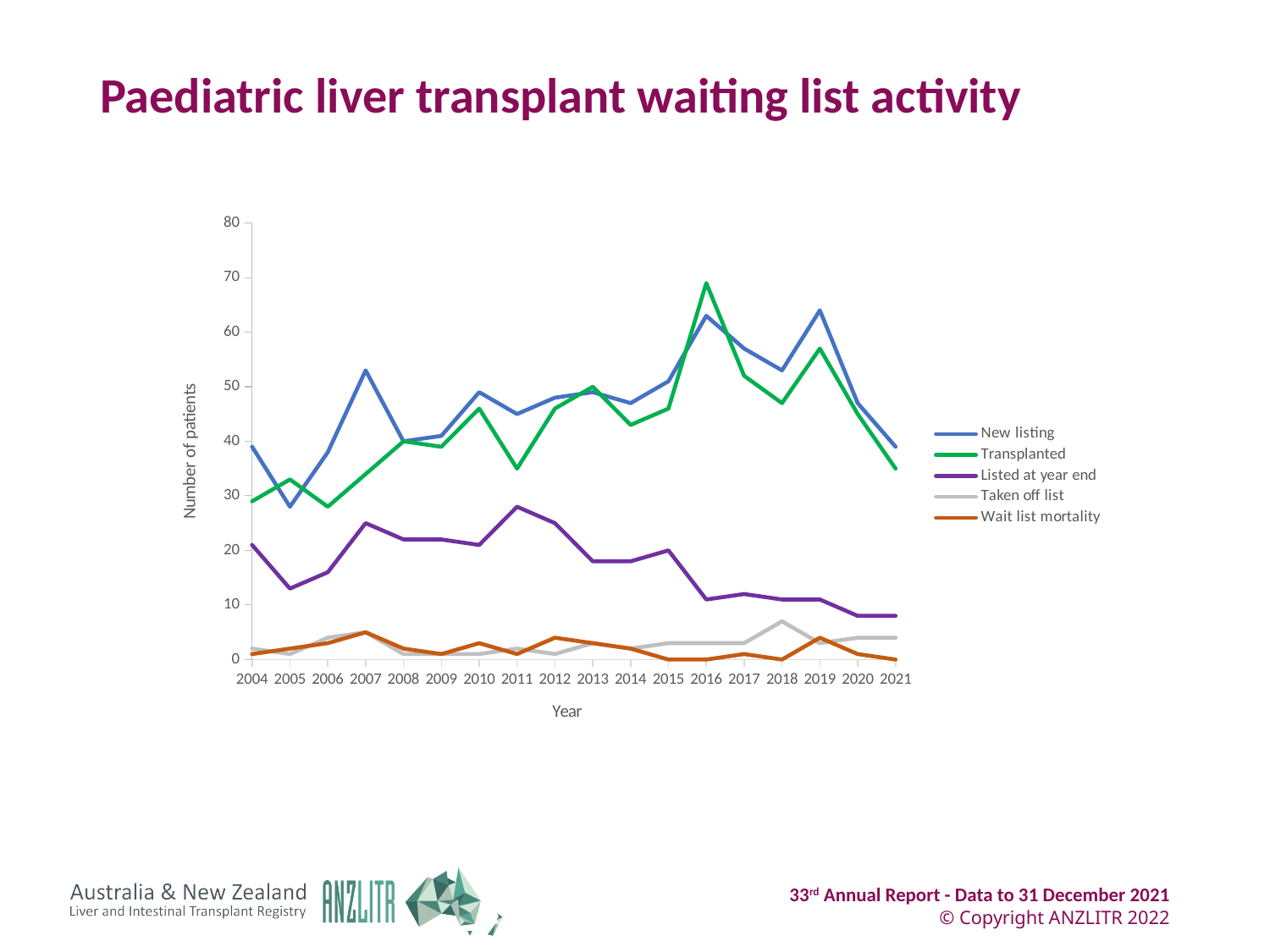
Is the Listed at year end value for 2016 greater or less than 20? less How many series does the legend list? 5 In which year does the Transplanted series reach its highest value? 2016 Does the Listed at year end series generally rise or fall from 2011 to 2021? Fall How many years are plotted along the x axis? 18 In 2011, which is larger: New listing or Transplanted? New listing In which year does the New listing series reach its lowest value? 2005 What is the title of the chart on the slide? Paediatric liver transplant waiting list activity Is the New listing value for 2007 greater or less than 50? greater What kind of chart is shown on the slide? Line chart In which year does the Listed at year end series reach its highest value? 2011 Is the Transplanted value for 2016 greater or less than 60? greater